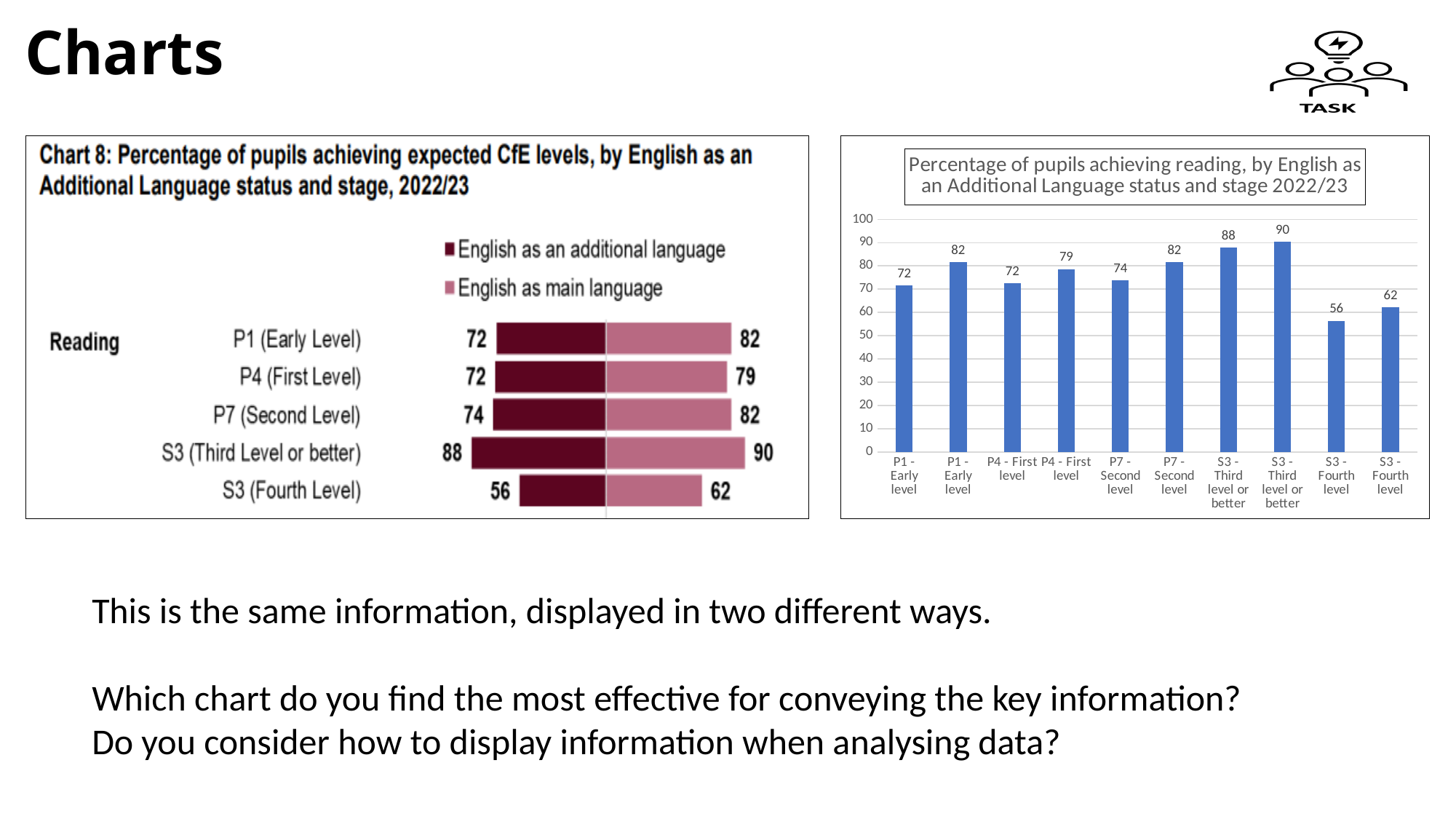
In the left chart (Chart 8), what percentage of pupils with English as main language achieved the expected level at S3 (Fourth Level)? 62 In the left chart (Chart 8), which stage has the lowest percentage for English as an additional language? S3 (Fourth Level) In the left chart (Chart 8), which is larger at P4 (First Level): the English as an additional language value or the English as main language value? English as main language What kind of chart is the left chart (Chart 8)? Bar chart In the right chart, what is the lowest value shown on any bar? 56 In the left chart (Chart 8), what is the difference between the English as main language and English as an additional language values at P1 (Early Level)? 10 In the left chart (Chart 8), what percentage of pupils with English as an additional language achieved the expected level at P7 (Second Level)? 74 In the left chart (Chart 8), which stage has the highest percentage for English as main language? S3 (Third Level or better) How many series does the legend of the left chart (Chart 8) list? 2 What is the title of the right chart? Percentage of pupils achieving reading, by English as an Additional Language status and stage 2022/23 In the right chart, what is the highest value shown on any bar? 90 How many bars are plotted in the right chart? 10